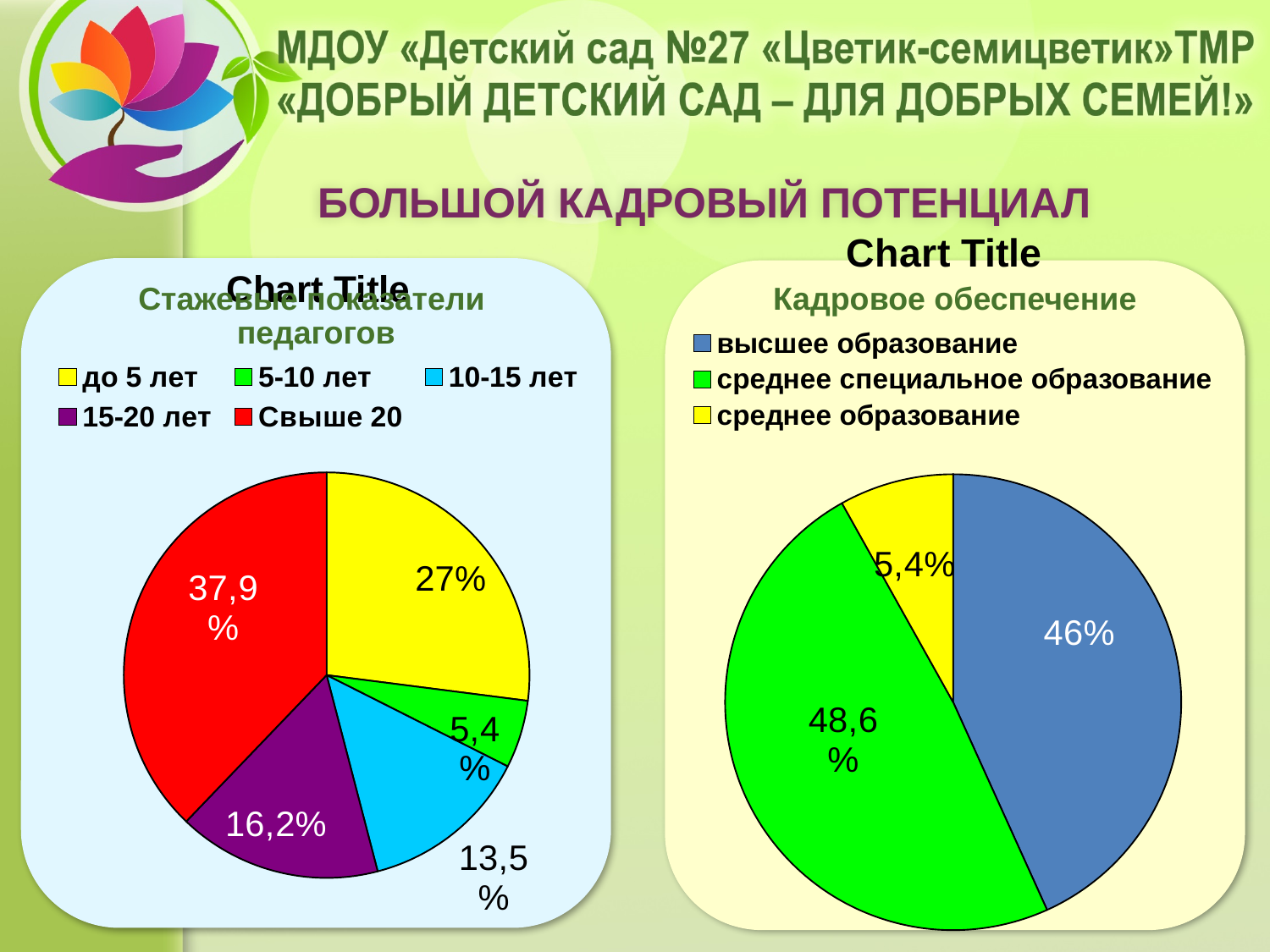
On the left pie chart (Стажевые показатели педагогов), what is the value for Свыше 20? 37,9% On the left pie chart (Стажевые показатели педагогов), which category has the smallest share? 5-10 лет What type of chart is the right chart (Кадровое обеспечение)? pie chart On the right pie chart (Кадровое обеспечение), which is larger: среднее специальное образование or высшее образование? среднее специальное образование On the right pie chart (Кадровое обеспечение), what is the value for высшее образование? 46% On the left pie chart (Стажевые показатели педагогов), which category has the largest share? Свыше 20 On the left pie chart (Стажевые показатели педагогов), how many categories does the legend list? 5 On the right pie chart (Кадровое обеспечение), what is the value for среднее образование? 5,4% On the left pie chart (Стажевые показатели педагогов), what is the difference between the shares for 15-20 лет and 10-15 лет? 2,7% On the right pie chart (Кадровое обеспечение), what colour is the slice for среднее специальное образование? green On the left pie chart (Стажевые показатели педагогов), what is the value for до 5 лет? 27% On the left pie chart (Стажевые показатели педагогов), what is the value for 10-15 лет? 13,5%